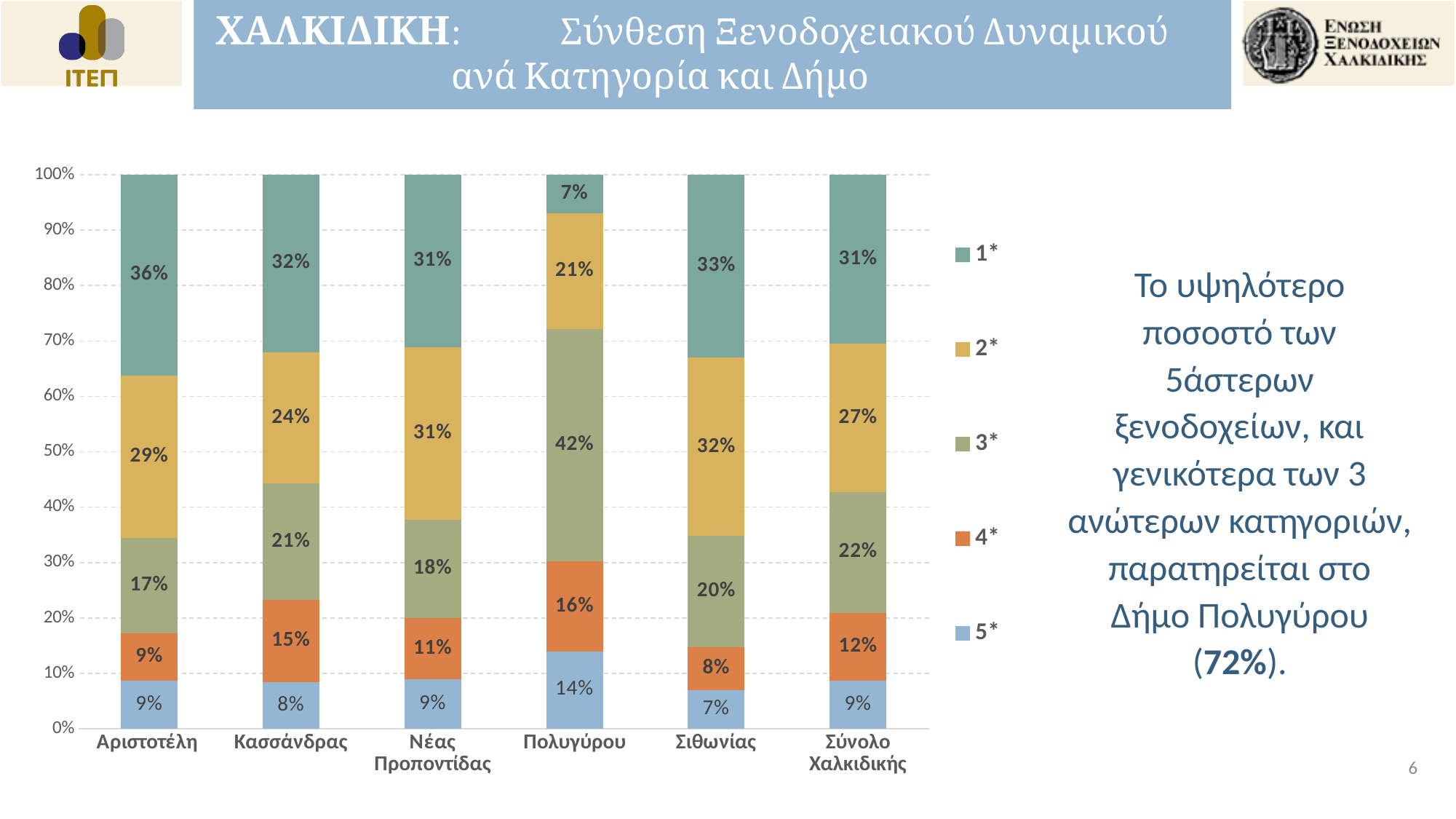
Which is larger: the 4* share in Κασσάνδρας or the 4* share in Σιθωνίας? Κασσάνδρας What is the share of 3* hotels in Σύνολο Χαλκιδικής? 22% What is the difference between the 2* share in Νέας Προποντίδας and the 2* share in Κασσάνδρας? 7% What type of chart is shown on the slide? stacked bar chart Which municipality has the highest share of 3* hotels? Πολυγύρου Which municipality has the lowest share of 1* hotels? Πολυγύρου What is the share of 1* hotels in Αριστοτέλη? 36% How many municipalities (categories) are shown on the x axis? 6 Which colour represents the 4* series in the legend? orange What is the combined share of 3*, 4* and 5* hotels in Πολυγύρου? 72% What is the share of 5* hotels in Πολυγύρου? 14% How many series does the legend list? 5